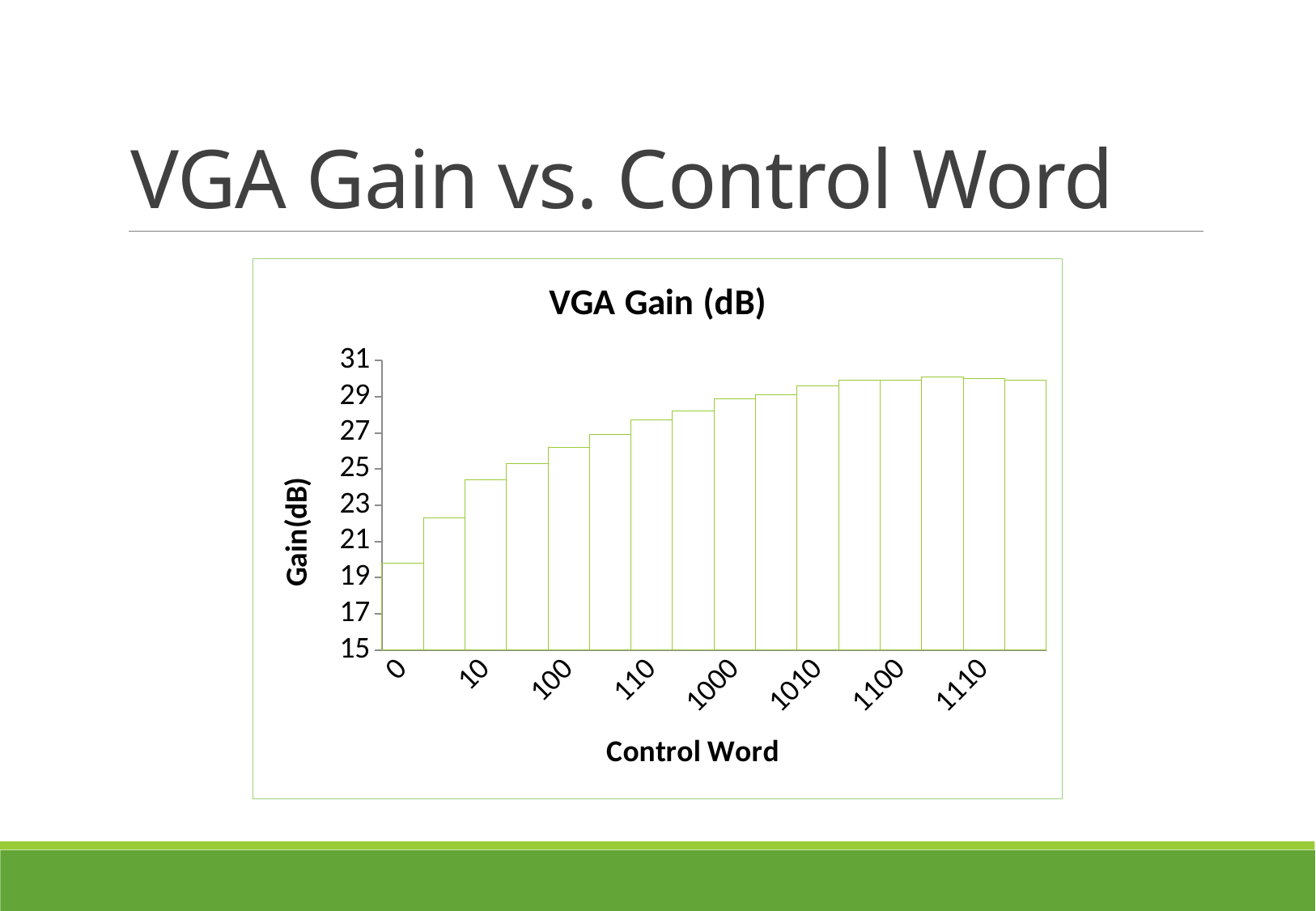
Is the gain for control word 1100 greater or less than 29? greater Which control word has the lowest gain? 0 Is the gain for control word 10 greater or less than 23? greater What kind of chart is shown on the slide? bar chart How many bars are plotted in the chart? 16 What is the label of the x axis? Control Word What is the title of the chart? VGA Gain (dB) Is the gain for control word 100 greater or less than 27? less Which has the larger gain, control word 0 or control word 10? 10 Which has the larger gain, control word 110 or control word 1110? 1110 Do the gain values generally rise or fall as the control word increases along the x axis? rise